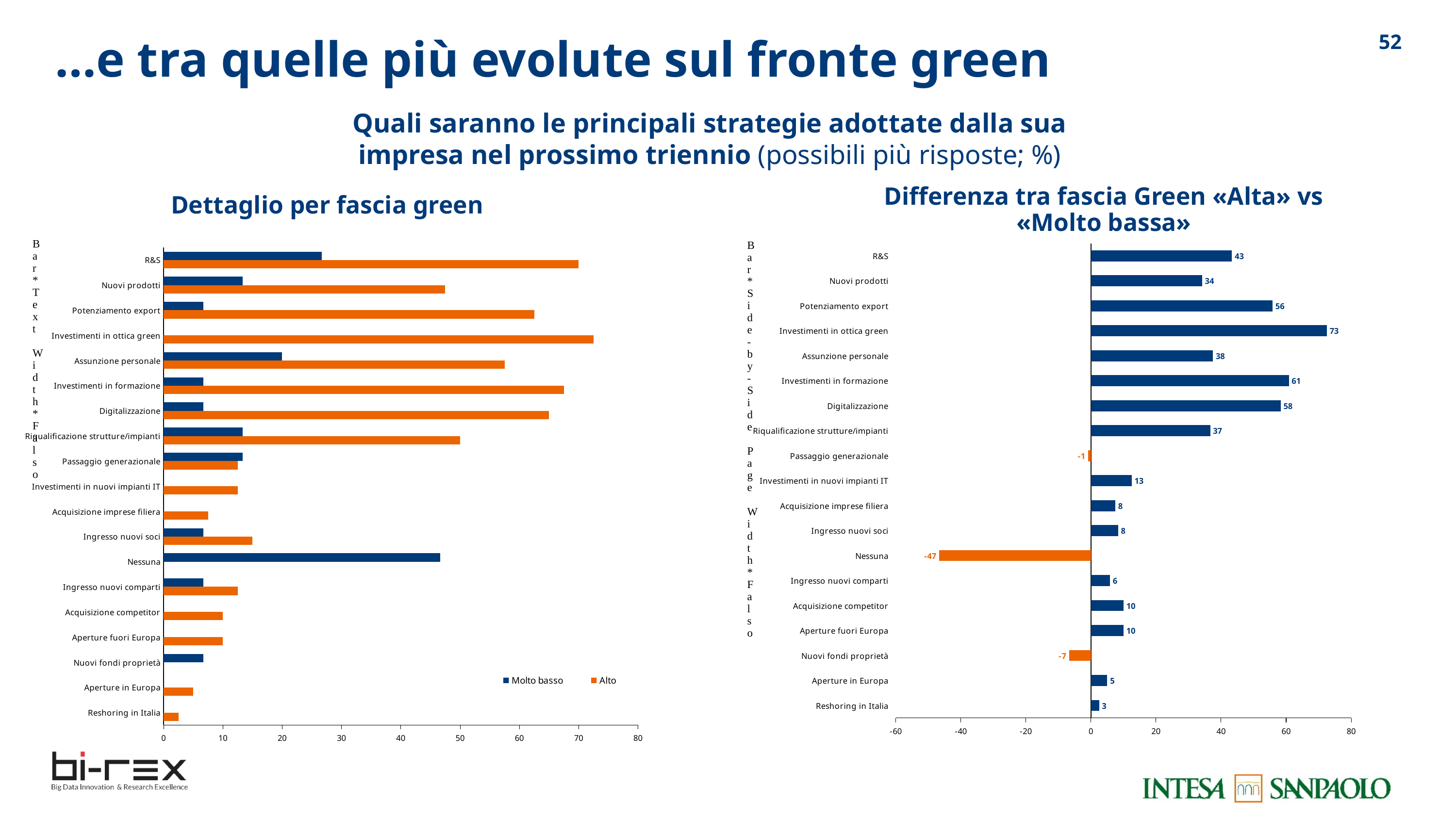
In the chart titled "Differenza tra fascia Green «Alta» vs «Molto bassa»", what is the value for Nessuna? -47 In the chart titled "Differenza tra fascia Green «Alta» vs «Molto bassa»", what is the value for Investimenti in ottica green? 73 In the chart titled "Differenza tra fascia Green «Alta» vs «Molto bassa»", which category has the highest value? Investimenti in ottica green In the chart titled "Dettaglio per fascia green", is the Molto basso value for Nessuna greater or less than 40? greater In the chart titled "Dettaglio per fascia green", how many series does the legend list? 2 In the chart titled "Differenza tra fascia Green «Alta» vs «Molto bassa»", what is the value for Nuovi fondi proprietà? -7 What kind of chart is the chart titled "Dettaglio per fascia green"? Bar chart In the chart titled "Dettaglio per fascia green", is the Alto value for R&S greater or less than 60? greater In the chart titled "Differenza tra fascia Green «Alta» vs «Molto bassa»", which is larger: the value for Potenziamento export or the value for R&S? Potenziamento export In the chart titled "Differenza tra fascia Green «Alta» vs «Molto bassa»", how many categories are shown? 19 In the chart titled "Differenza tra fascia Green «Alta» vs «Molto bassa»", what is the difference between the values for Investimenti in formazione and Digitalizzazione? 3 In the chart titled "Differenza tra fascia Green «Alta» vs «Molto bassa»", which category has the lowest value? Nessuna